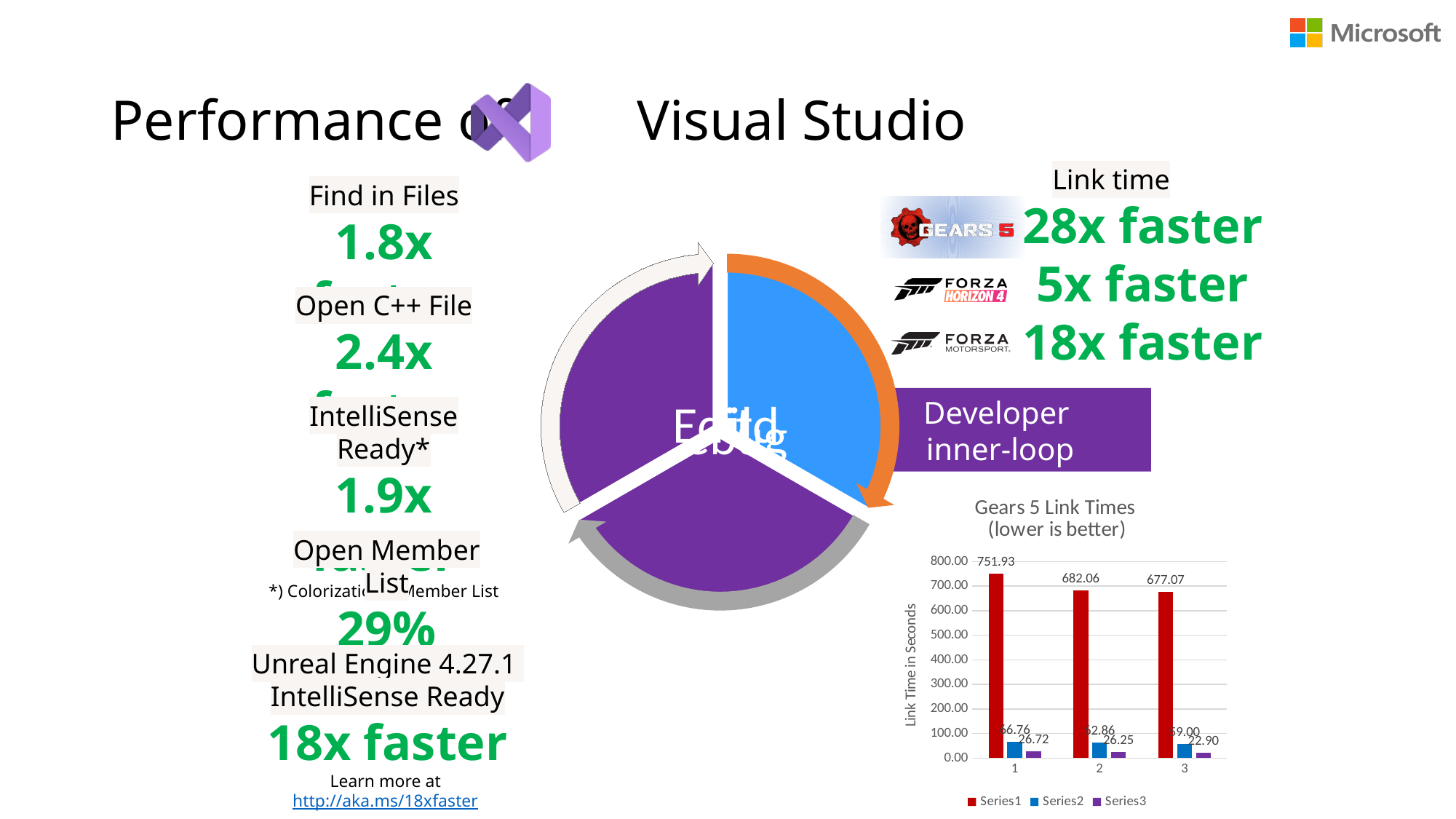
In the Gears 5 Link Times chart, what is the difference between the Series1 values for category 1 and category 2? 69.87 In the Gears 5 Link Times chart, what is the Series1 value for category 2? 682.06 In the Gears 5 Link Times chart, what is the Series3 value for category 3? 22.90 What kind of chart is the Gears 5 Link Times chart? bar chart What is the y-axis title of the Gears 5 Link Times chart? Link Time in Seconds In the Gears 5 Link Times chart, which category has the highest Series1 value? 1 In the Gears 5 Link Times chart, what is the Series3 value for category 1? 26.72 In the Gears 5 Link Times chart, what is the Series1 value for category 3? 677.07 In the Gears 5 Link Times chart, do the Series1 values rise or fall from category 1 to category 3? fall How many series does the legend of the Gears 5 Link Times chart list? 3 How many categories are shown on the x axis of the Gears 5 Link Times chart? 3 In the Gears 5 Link Times chart, what is the Series1 value for category 1? 751.93